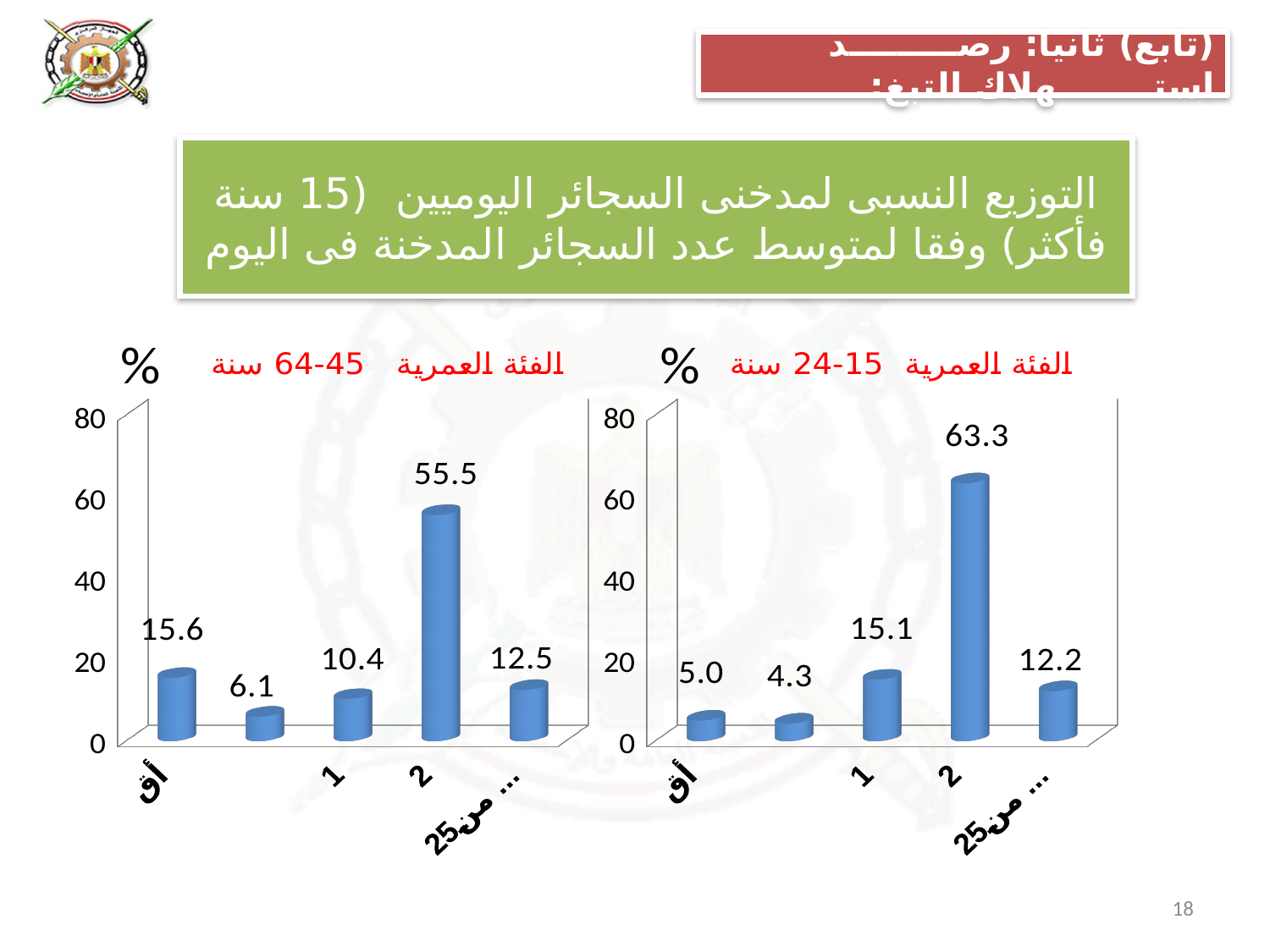
In the chart for age group 45-64 (الفئة العمرية 45-64 سنة), what is the lowest value shown? 6.1 In the chart for age group 15-24 (الفئة العمرية 15-24 سنة), what is the lowest value shown? 4.3 What type of chart is used for the age group 45-64 (الفئة العمرية 45-64 سنة) data? Bar chart In the chart for age group 45-64 (الفئة العمرية 45-64 سنة), is the value for category 2 greater or less than 40? greater In the chart for age group 15-24 (الفئة العمرية 15-24 سنة), which category has the highest value? 2 In the chart for age group 45-64 (الفئة العمرية 45-64 سنة), what is the value of the first (leftmost) bar? 15.6 What is the difference between the value for category 2 in the 15-24 age group chart and the value for category 2 in the 45-64 age group chart? 7.8 In the chart for age group 45-64 (الفئة العمرية 45-64 سنة), what is the value for category 1? 10.4 In the chart for age group 15-24 (الفئة العمرية 15-24 سنة), what is the value for category 1? 15.1 In the chart for age group 15-24 (الفئة العمرية 15-24 سنة), what is the value for category 2? 63.3 How many bars are plotted in the chart for age group 15-24 (الفئة العمرية 15-24 سنة)? 5 In the chart for age group 45-64 (الفئة العمرية 45-64 سنة), what is the value for category 2? 55.5